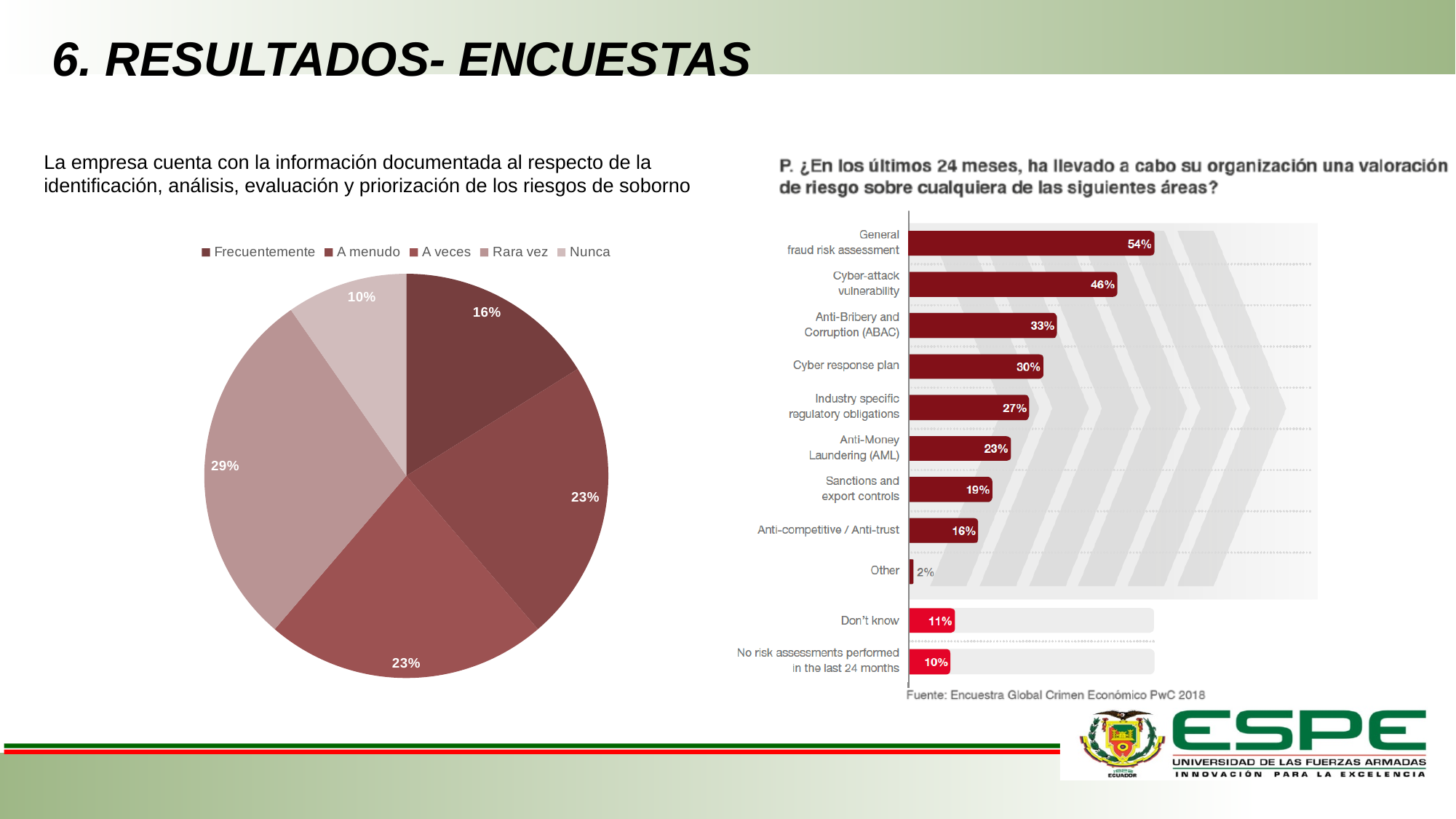
On the pie chart on the left, how many categories does the legend list? 5 On the bar chart on the right, which area has the highest value? General fraud risk assessment What type of chart is shown on the right side of the slide? Bar chart On the bar chart on the right, what is the difference between 'General fraud risk assessment' and 'Sanctions and export controls'? 35% On the pie chart on the left, which category has the largest share? Rara vez On the pie chart on the left, what percentage corresponds to 'Nunca'? 10% On the pie chart on the left, what percentage corresponds to 'Rara vez'? 29% On the pie chart on the left, what is the difference between the 'Rara vez' share and the 'Frecuentemente' share? 13% On the bar chart on the right, which is larger: 'Cyber response plan' or 'Anti-Money Laundering (AML)'? Cyber response plan On the bar chart on the right, what is the value for 'Anti-Bribery and Corruption (ABAC)'? 33% On the bar chart on the right, what is the value for 'Cyber-attack vulnerability'? 46% On the pie chart on the left, which category has the smallest share? Nunca